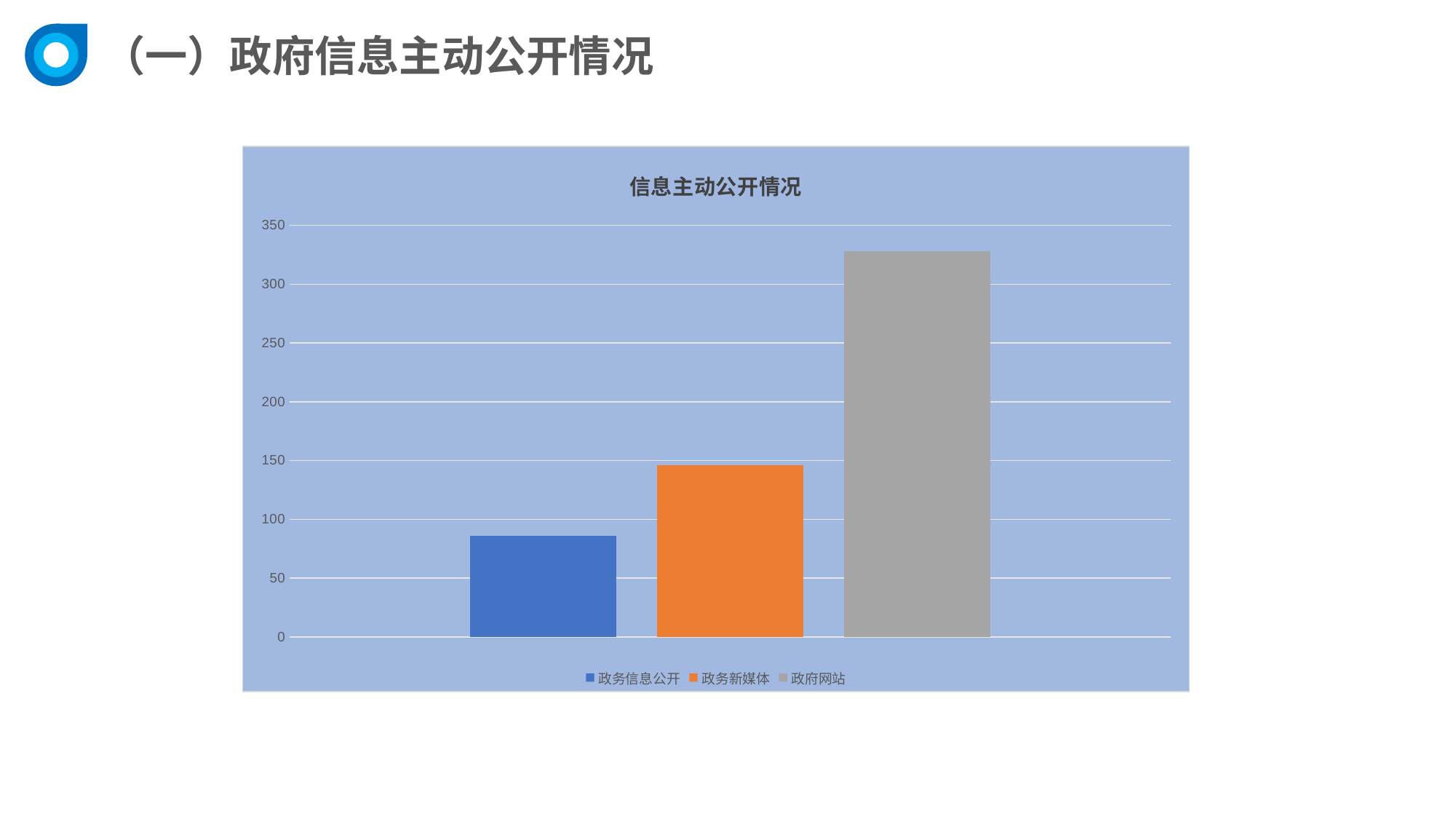
Is the value for 政务新媒体 greater or less than 100? greater How many series does the legend list? 3 Which series has the lowest value? 政务信息公开 What is the title of the chart? 信息主动公开情况 Is the value for 政务信息公开 greater or less than 100? less What colour is the bar for 政府网站? gray Which series has the highest value? 政府网站 How many bars are plotted in the chart? 3 Which is larger, the value for 政务新媒体 or the value for 政务信息公开? 政务新媒体 What kind of chart is shown on the slide? bar chart Is the value for 政府网站 greater or less than 300? greater Do the bar values rise or fall from left to right across the chart? rise